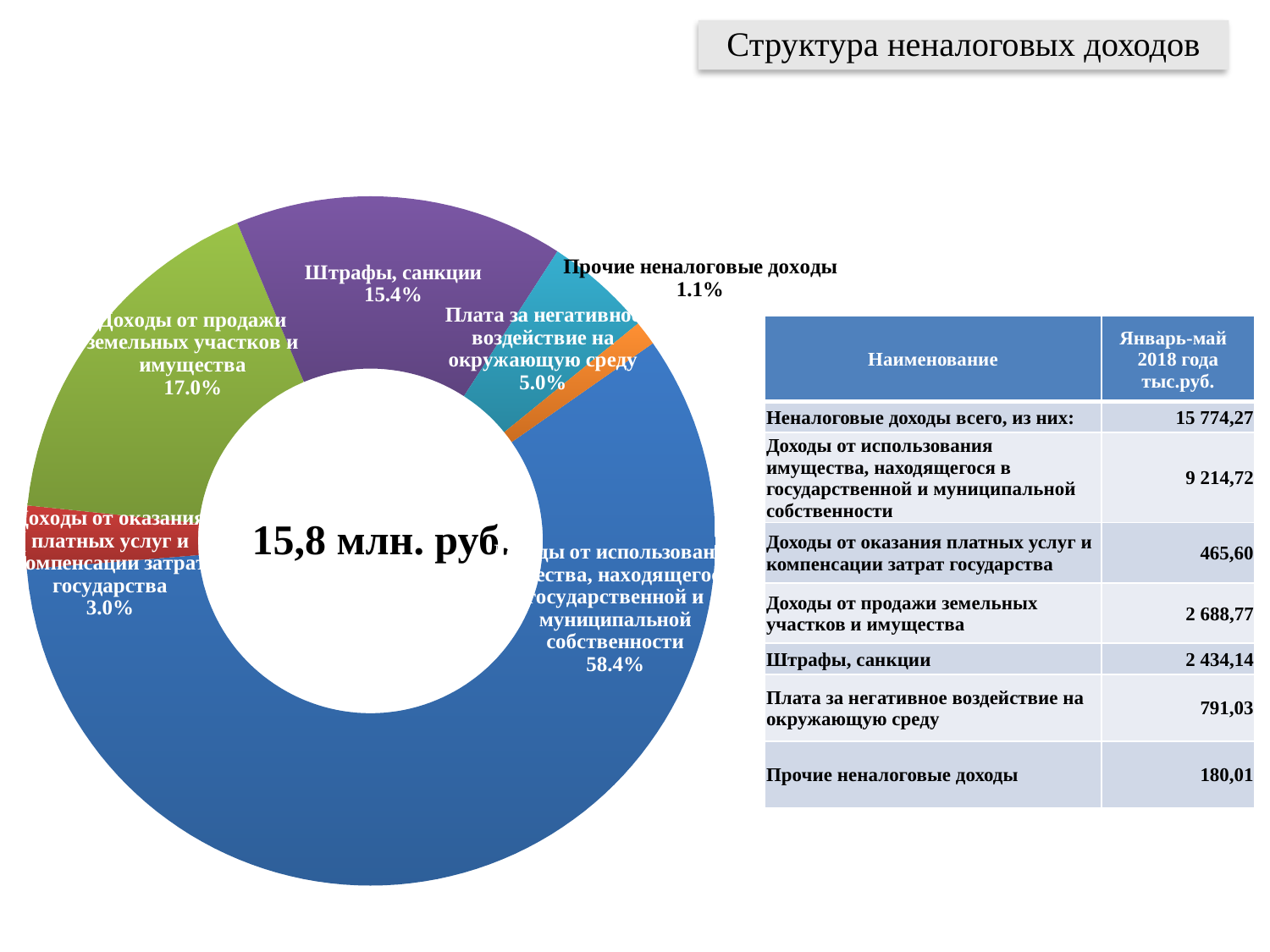
Which is larger in the doughnut chart: "Штрафы, санкции" or "Доходы от продажи земельных участков и имущества"? Доходы от продажи земельных участков и имущества What is the difference in percentage points between "Доходы от продажи земельных участков и имущества" and "Штрафы, санкции" in the doughnut chart? 1.6 percentage points How many slices does the doughnut chart have? 6 What share of the doughnut chart does "Штрафы, санкции" represent? 15.4% What total value is printed in the centre of the doughnut chart? 15,8 млн. руб. Which slice of the doughnut chart is the largest? Доходы от использования имущества, находящегося в государственной и муниципальной собственности (58.4%) Which slice of the doughnut chart is the smallest? Прочие неналоговые доходы (1.1%) What share of the doughnut chart does "Прочие неналоговые доходы" represent? 1.1% What share of the doughnut chart does "Плата за негативное воздействие на окружающую среду" represent? 5.0% What share of the doughnut chart does "Доходы от продажи земельных участков и имущества" represent? 17.0% What share of the doughnut chart does "Доходы от оказания платных услуг и компенсации затрат государства" represent? 3.0% What kind of chart is shown on the slide? Doughnut (pie) chart